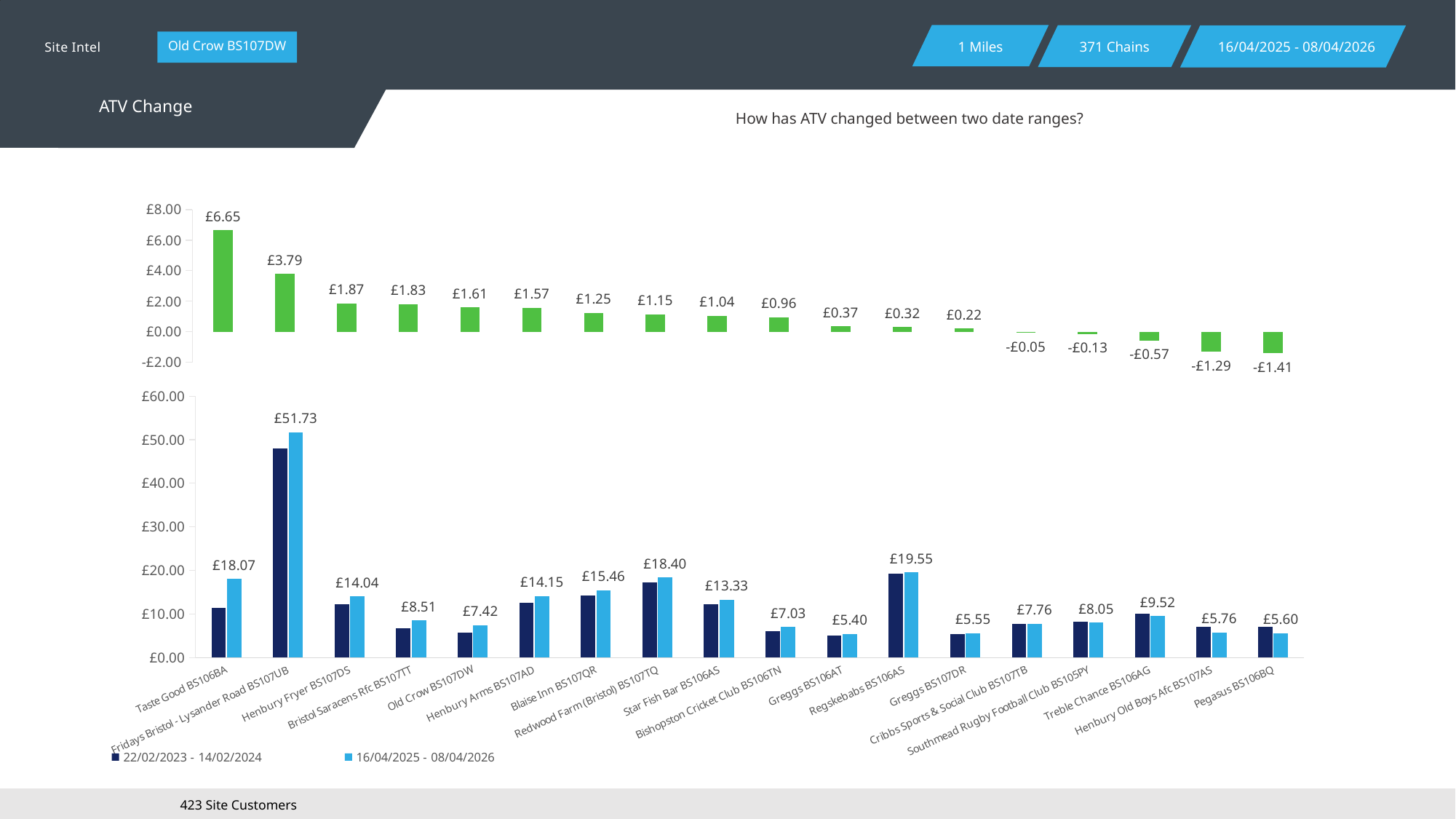
In the top chart, what is the difference between the ATV change for Taste Good BS106BA and Fridays Bristol - Lysander Road BS107UB? £2.86 In the top chart, what is the ATV change for Taste Good BS106BA? £6.65 In the bottom chart, which category has the lowest labelled value for the 16/04/2025 - 08/04/2026 period? Greggs BS106AT How many categories are shown on the x axis of the bottom chart? 18 In the bottom chart, is the 22/02/2023 - 14/02/2024 value for Fridays Bristol - Lysander Road BS107UB greater or less than £40.00? greater What kind of chart is the top chart? Bar chart In the bottom chart, which is larger for the 16/04/2025 - 08/04/2026 period: Regskebabs BS106AS or Redwood Farm (Bristol) BS107TQ? Regskebabs BS106AS In the bottom chart, which category has the highest value for the 16/04/2025 - 08/04/2026 period? Fridays Bristol - Lysander Road BS107UB In the top chart, which category has the lowest ATV change? Pegasus BS106BQ How many series does the legend of the bottom chart list? 2 In the bottom chart, what is the value for Fridays Bristol - Lysander Road BS107UB in the 16/04/2025 - 08/04/2026 period? £51.73 In the top chart, what is the ATV change for Old Crow BS107DW? £1.61